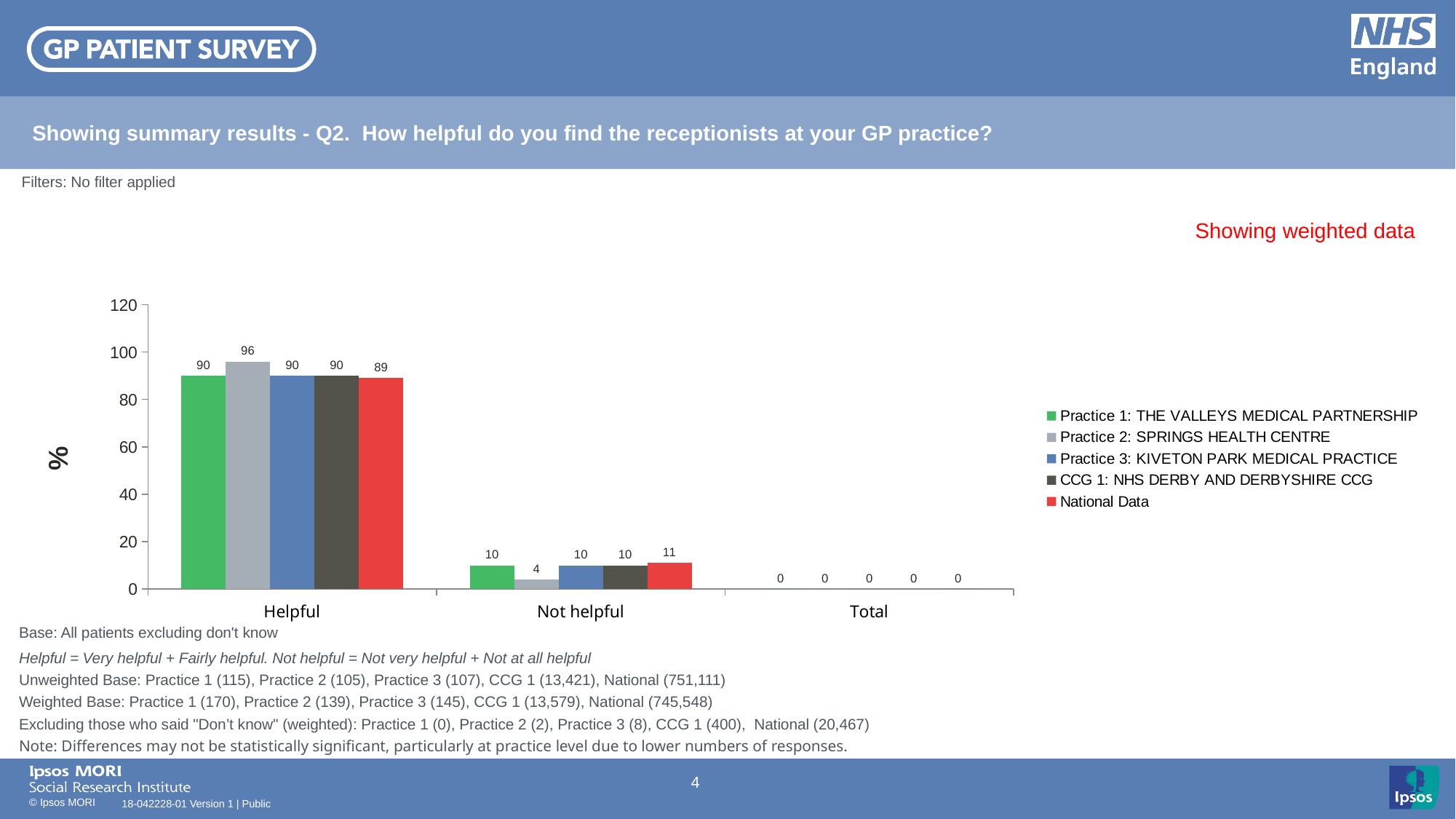
What is the difference between the Not helpful values for National Data and Practice 2: SPRINGS HEALTH CENTRE? 7 What is the National Data value for the Not helpful category? 11 Which series has the highest value in the Helpful category? Practice 2: SPRINGS HEALTH CENTRE How many series does the legend list? 5 What is the value for Practice 2: SPRINGS HEALTH CENTRE in the Helpful category? 96 What is the label on the y axis of the chart? % What is the value for Practice 1: THE VALLEYS MEDICAL PARTNERSHIP in the Helpful category? 90 What kind of chart is shown on the slide? Bar chart What is the difference between the Helpful values for Practice 2: SPRINGS HEALTH CENTRE and National Data? 7 How many categories are shown on the x axis? 3 Which is larger: the Helpful value for Practice 2: SPRINGS HEALTH CENTRE or the Helpful value for National Data? Practice 2: SPRINGS HEALTH CENTRE Which series has the lowest value in the Not helpful category? Practice 2: SPRINGS HEALTH CENTRE